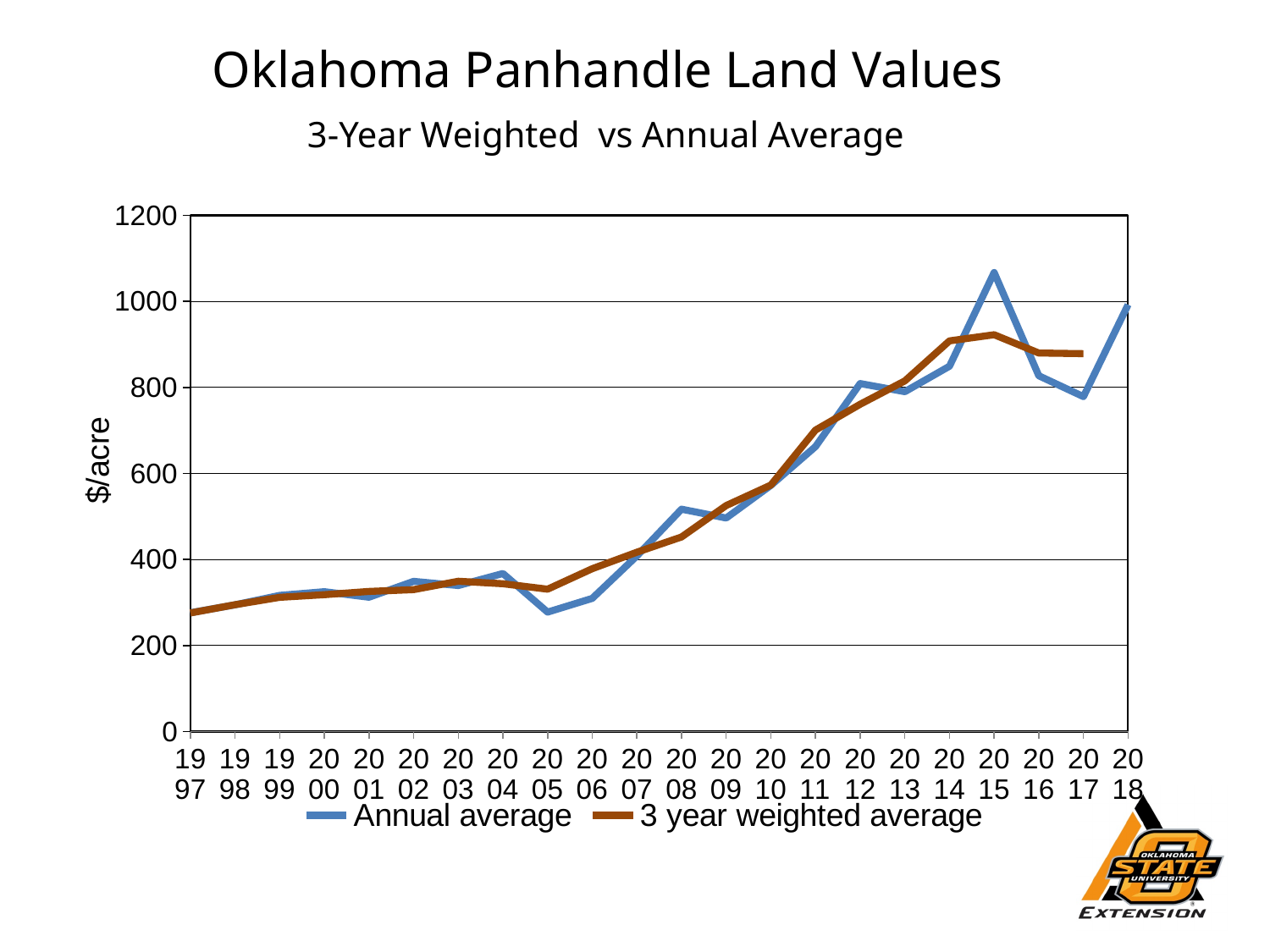
In 2015, which series has the larger value, Annual average or 3 year weighted average? Annual average What kind of chart is shown on the slide? line chart Is the 3 year weighted average value for 2017 greater or less than 800? greater Is the Annual average value for 2005 greater or less than 400? less How many years are plotted along the x axis? 22 In which year does the Annual average series reach its highest value? 2015 Overall, do the land values rise or fall from 1997 to 2018? rise What is the label on the y axis? $/acre In 2017, which series has the larger value, Annual average or 3 year weighted average? 3 year weighted average Is the Annual average value for 2015 greater or less than 1000? greater How many series does the legend list? 2